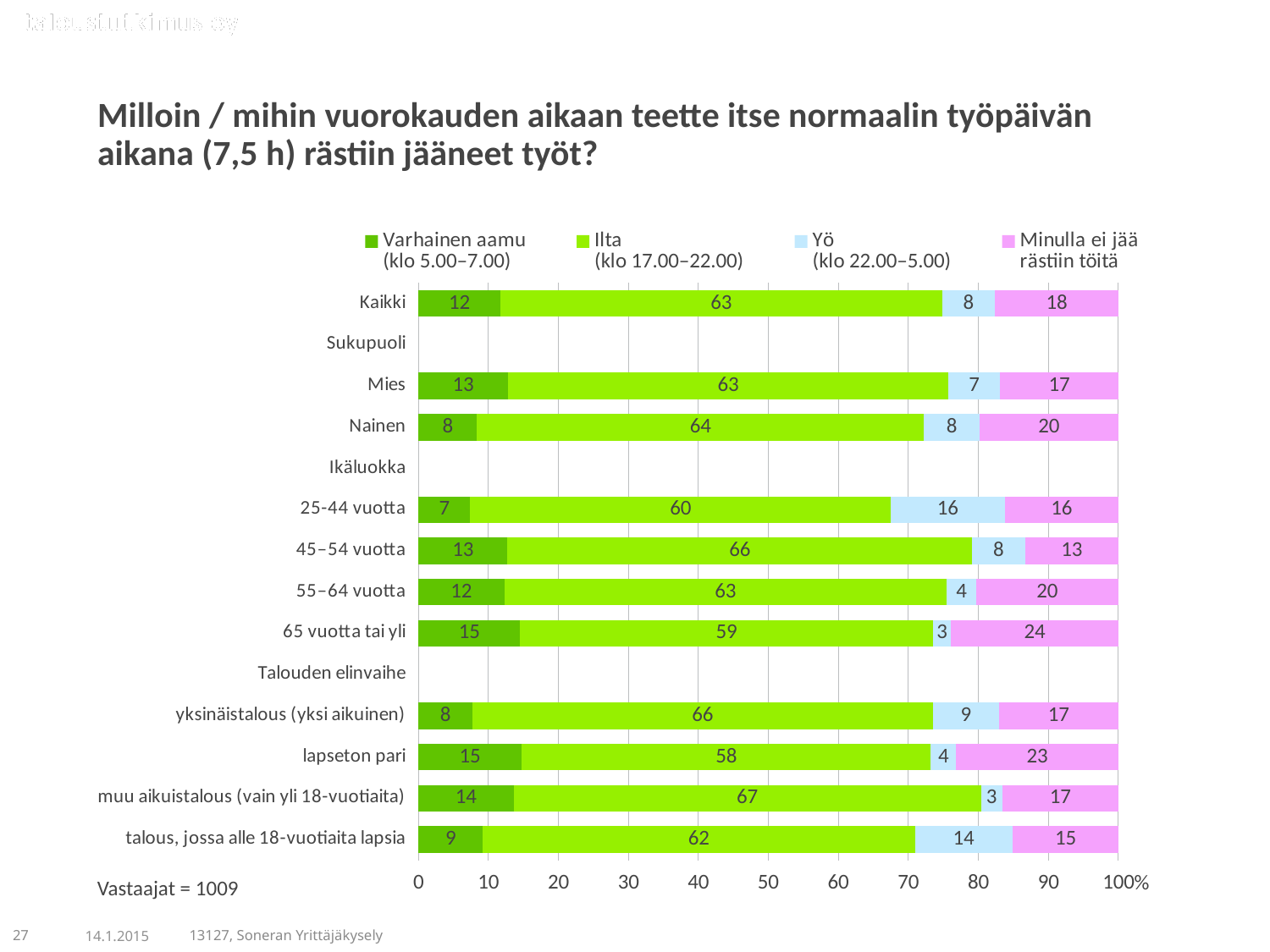
Which category has the highest value for "Ilta (klo 17.00–22.00)"? muu aikuistalous (vain yli 18-vuotiaita) How many series does the legend list? 4 What is the value of "Minulla ei jää rästiin töitä" for "65 vuotta tai yli"? 24 Which category has the lowest value for "Varhainen aamu (klo 5.00–7.00)"? 25-44 vuotta What is the value of "Varhainen aamu (klo 5.00–7.00)" for "lapseton pari"? 15 What is the difference between the "Minulla ei jää rästiin töitä" values for "Nainen" and "Mies"? 3 What is the total of the stacked bar for "Mies"? 100 Which has the larger "Yö (klo 22.00–5.00)" value, "25-44 vuotta" or "45–54 vuotta"? 25-44 vuotta What is the value of "Yö (klo 22.00–5.00)" for "25-44 vuotta"? 16 What kind of chart is shown on the slide? Stacked bar chart Which category has the highest value for "Minulla ei jää rästiin töitä"? 65 vuotta tai yli What is the value of "Ilta (klo 17.00–22.00)" for the "Kaikki" category? 63